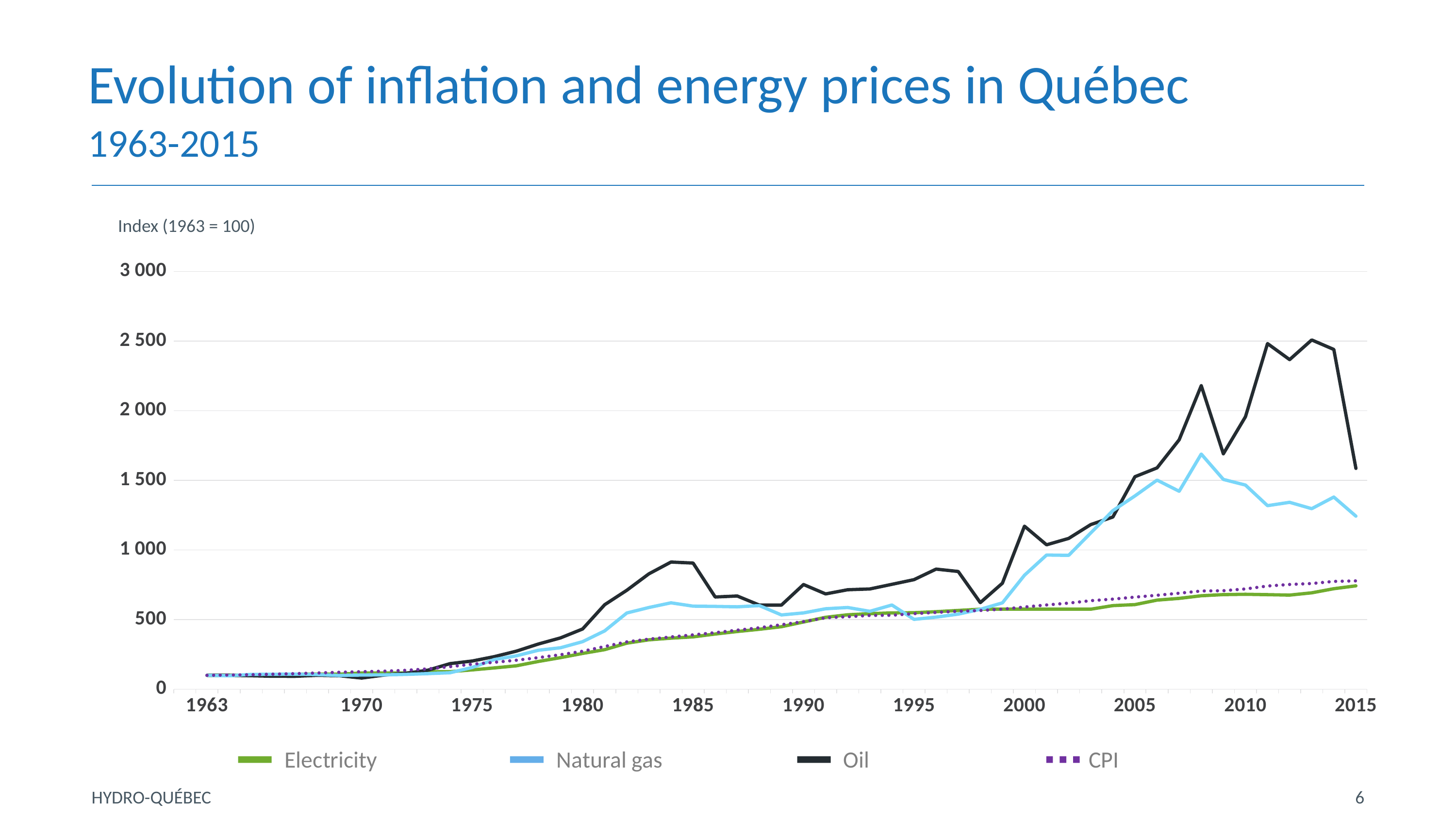
What kind of chart is shown on the slide? line chart How many series does the legend list? 4 In 2010, which is larger, the index value for Oil or for Natural gas? Oil What is the title of the chart on the slide? Evolution of inflation and energy prices in Québec 1963-2015 What is the index value of every series in 1963? 100 Does the CPI series generally rise or fall from 1963 to 2015? rise Which series has the highest index value in 2015? Oil Is the index value for Oil in 2010 greater or less than 1 500? greater Is the index value for Electricity in 2015 greater or less than 1 000? less Which series has the lowest index value in 2015? Electricity Is the index value for Natural gas in 2015 greater or less than 1 000? greater